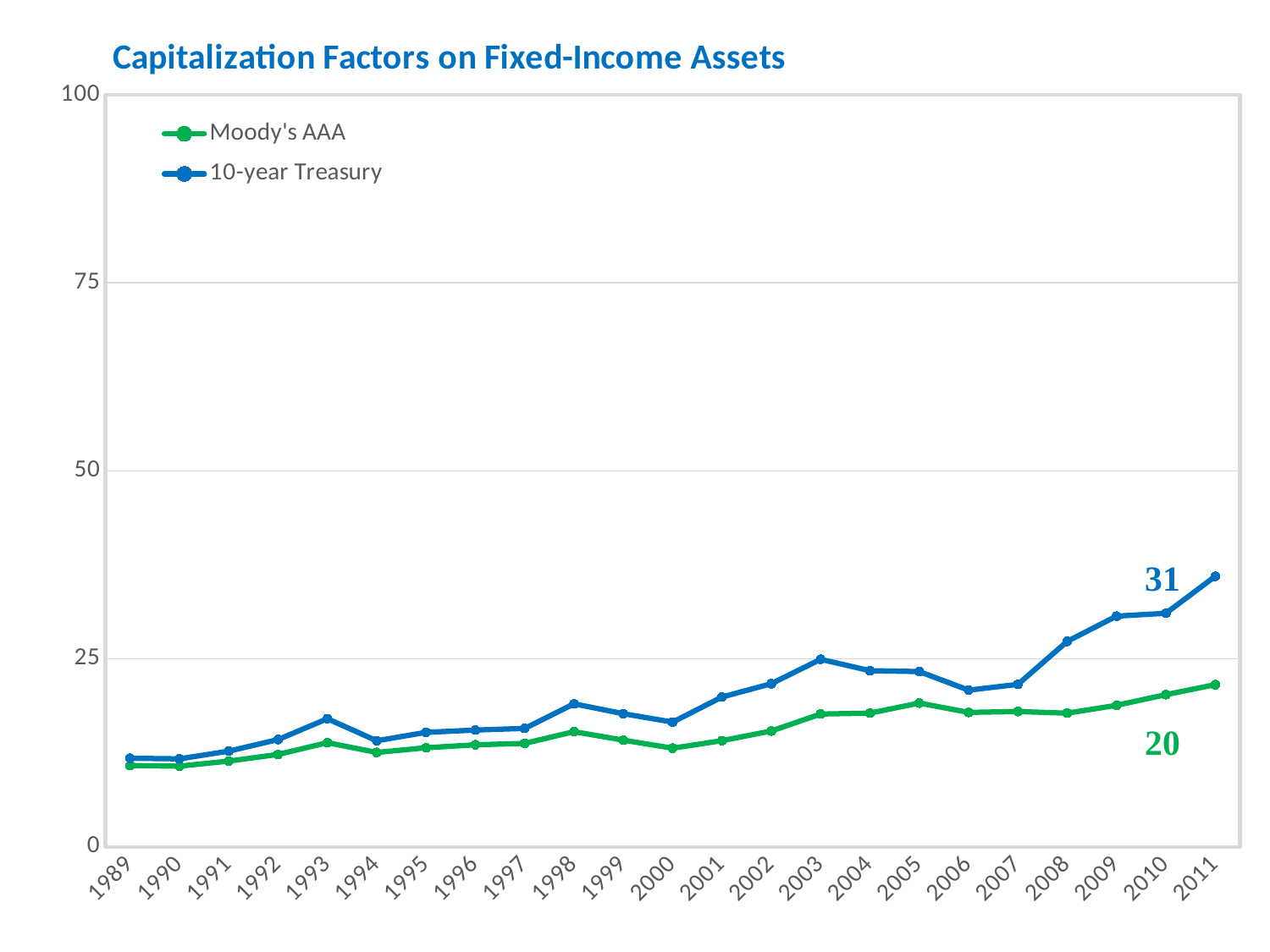
What value is printed as a data label on the Moody's AAA line? 20 What is the title of the chart? Capitalization Factors on Fixed-Income Assets How many years are plotted along the x axis? 23 Is the value for 10-year Treasury in 2011 greater or less than 25? greater Do the 10-year Treasury values generally rise or fall from 1989 to 2011? rise Which series is higher in 2011, Moody's AAA or 10-year Treasury? 10-year Treasury What is the difference between the labeled 10-year Treasury value (31) and the labeled Moody's AAA value (20)? 11 What kind of chart is shown on the slide? line chart How many series does the legend list? 2 In which year does the 10-year Treasury series reach its highest value? 2011 What value is printed as a data label on the 10-year Treasury line? 31 Is the value for Moody's AAA in 1989 greater or less than 25? less